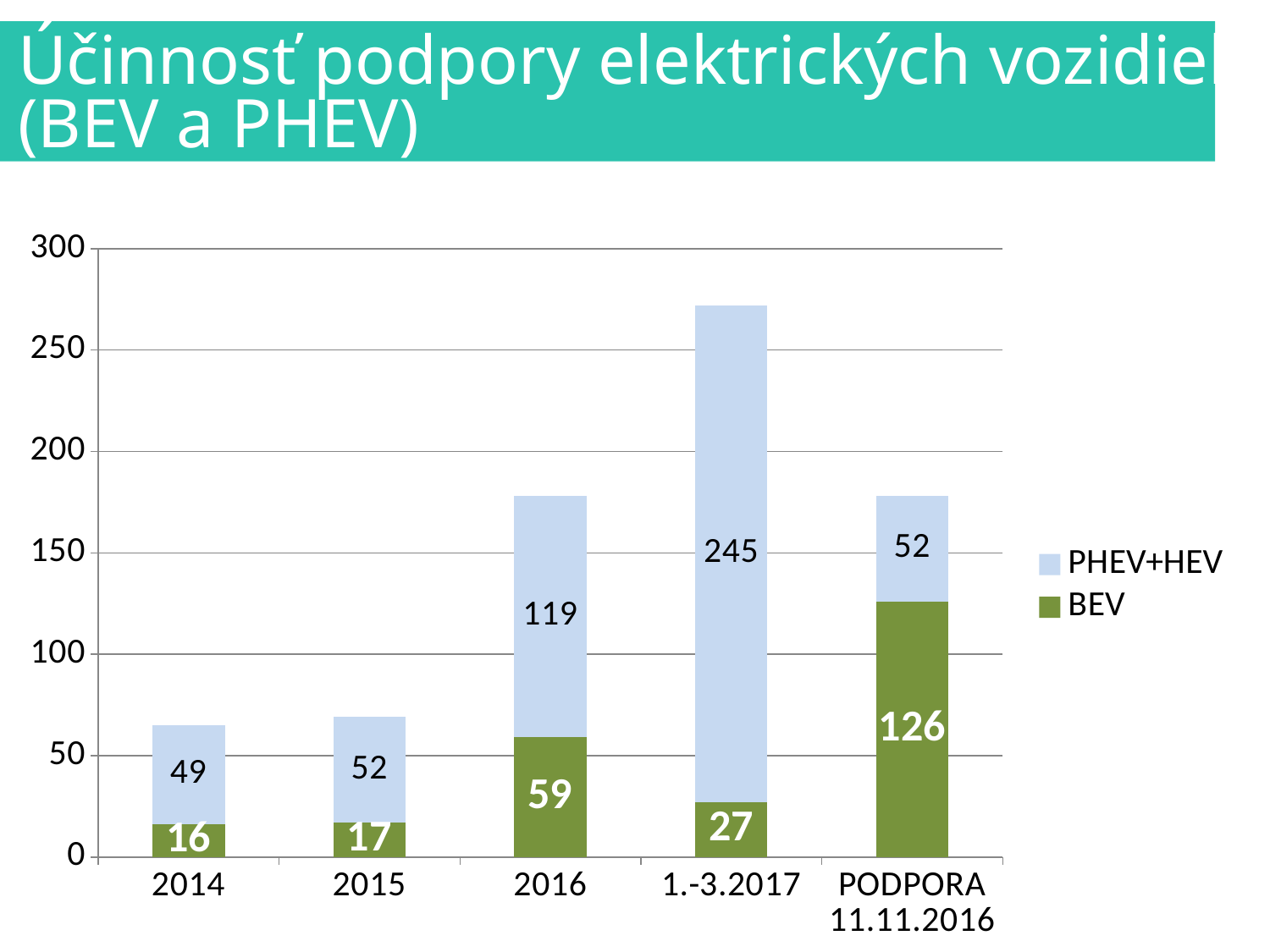
What is the total of the stacked bar for 1.-3.2017? 272 Which is larger, the BEV value for 2015 or the BEV value for 1.-3.2017? 1.-3.2017 What is the BEV value for 2016? 59 How many series does the legend list? 2 What is the difference between the PHEV+HEV values for 2016 and 2015? 67 How many categories are shown on the x axis? 5 What is the BEV value for PODPORA 11.11.2016? 126 What kind of chart is shown on the slide? Stacked bar chart What is the PHEV+HEV value for 1.-3.2017? 245 Which category has the highest BEV value? PODPORA 11.11.2016 What is the total of the stacked bar for 2014? 65 Which category has the lowest PHEV+HEV value? 2014